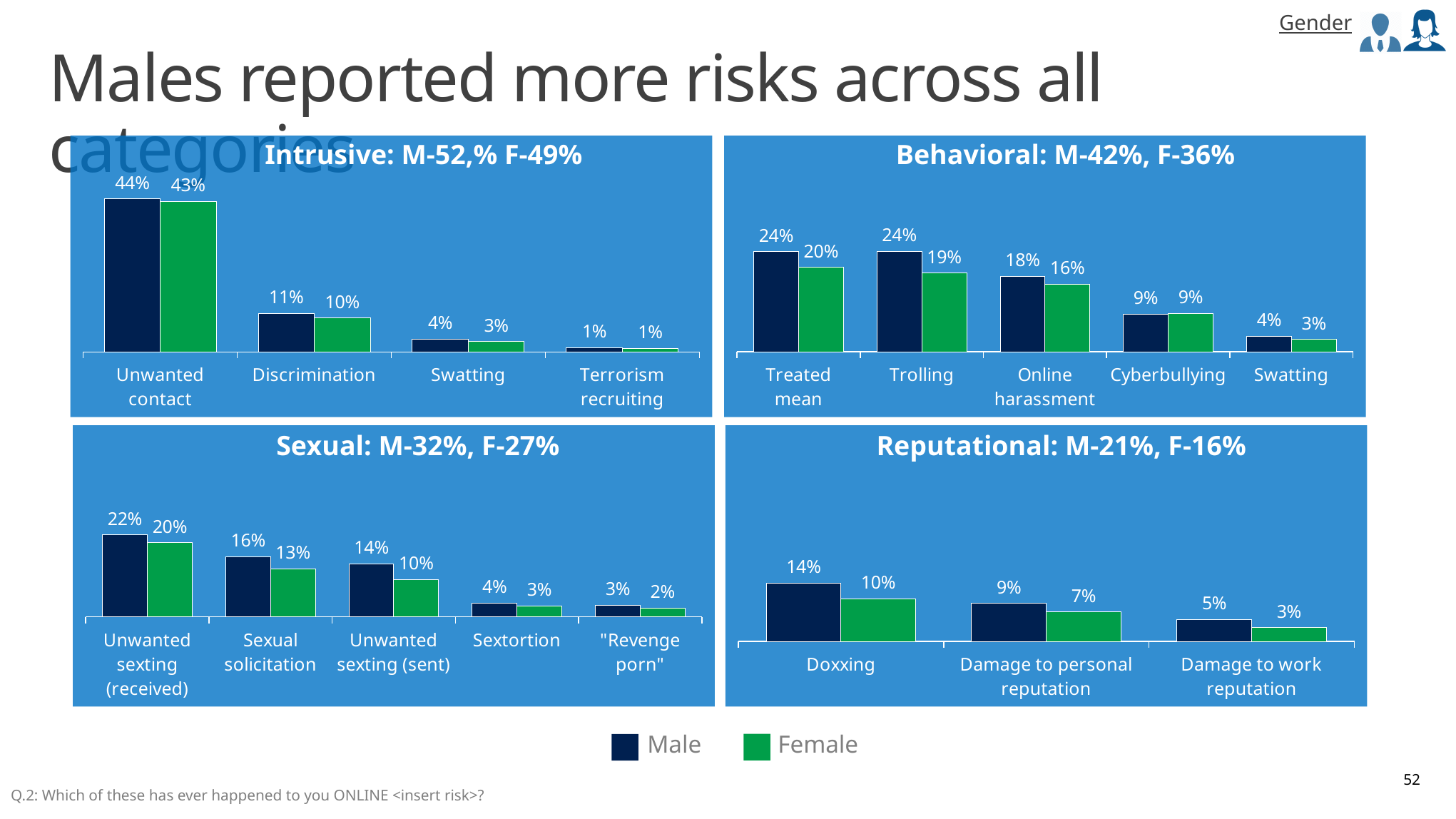
How many categories are shown in the Behavioral chart? 5 In the Reputational chart, which category has the highest Male value? Doxxing In the Sexual chart, what is the Male value for Unwanted sexting (sent)? 14% In the Intrusive chart, which category has the lowest Female value? Terrorism recruiting In the Behavioral chart, what is the Female value for Trolling? 19% In the Reputational chart, what is the Female value for Damage to work reputation? 3% In the Reputational chart, what is the difference between the Male and Female values for Doxxing? 4% In the Sexual chart, what is the difference between the Male and Female values for Sexual solicitation? 3% What kind of chart is the Sexual chart? Bar chart In the Behavioral chart, which is larger: the Male value for Online harassment or the Male value for Cyberbullying? Online harassment In the Intrusive chart, what is the Male value for Unwanted contact? 44% How many series does the legend list? 2